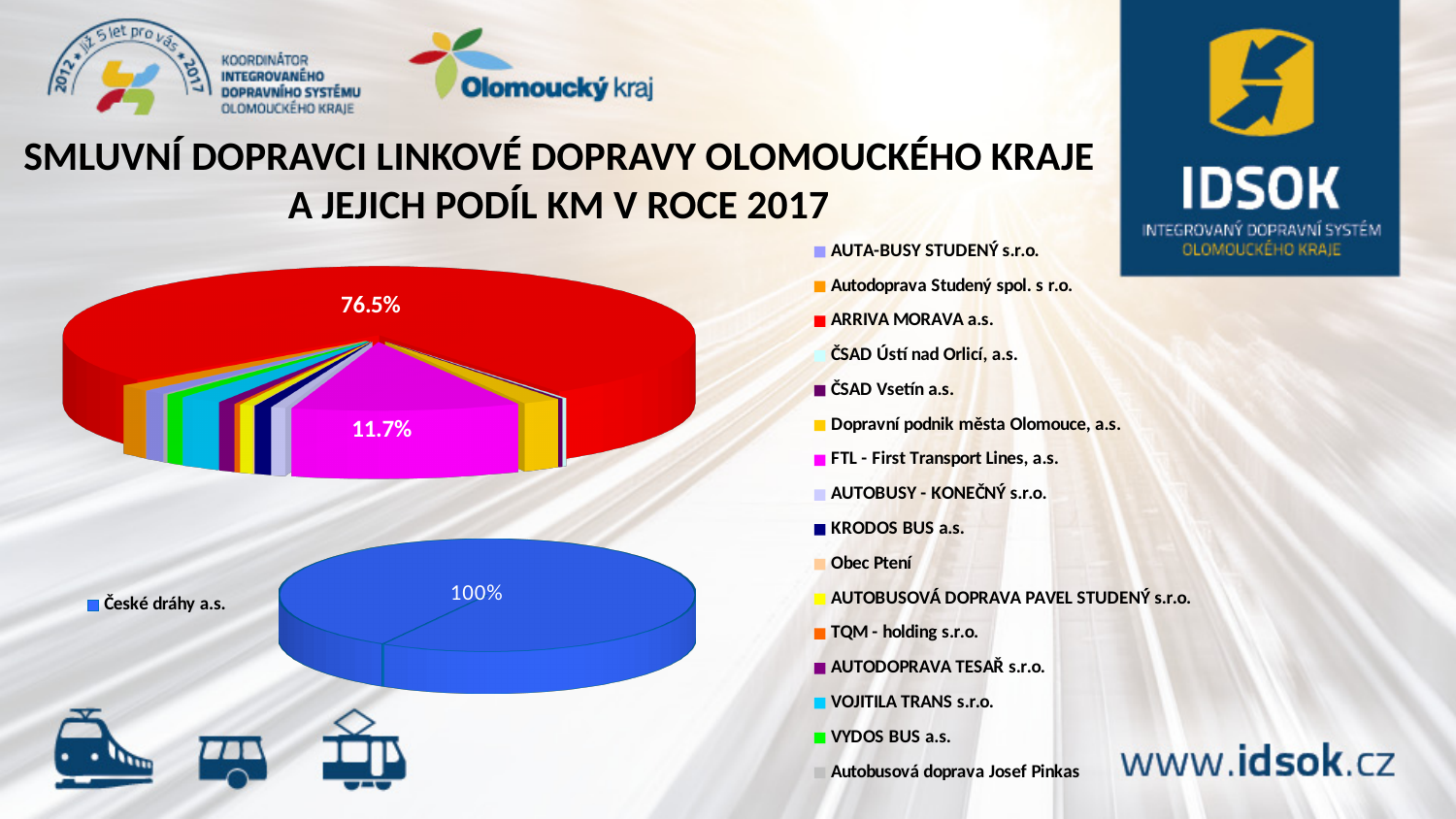
How many companies are listed in the legend of the top pie chart? 16 In the top pie chart, what share is shown for the magenta slice labelled with a value? 11.7% In the top pie chart, which slice is larger: the red slice or the magenta slice? the red slice In the bottom pie chart, what share is shown for České dráhy a.s.? 100% What is the title of the slide containing the charts? SMLUVNÍ DOPRAVCI LINKOVÉ DOPRAVY OLOMOUCKÉHO KRAJE A JEJICH PODÍL KM V ROCE 2017 Which company is represented by the magenta slice in the top pie chart? FTL - First Transport Lines, a.s. What type of chart is used on this slide? pie chart Is the share of the red slice in the top pie chart greater or less than 50%? greater How many entries does the legend of the bottom pie chart list? 1 In the top pie chart, what share is shown for the largest (red) slice? 76.5% In the top pie chart, what is the difference in percentage points between the 76.5% slice and the 11.7% slice? 64.8 In the top pie chart, which company has the largest share? ARRIVA MORAVA a.s.